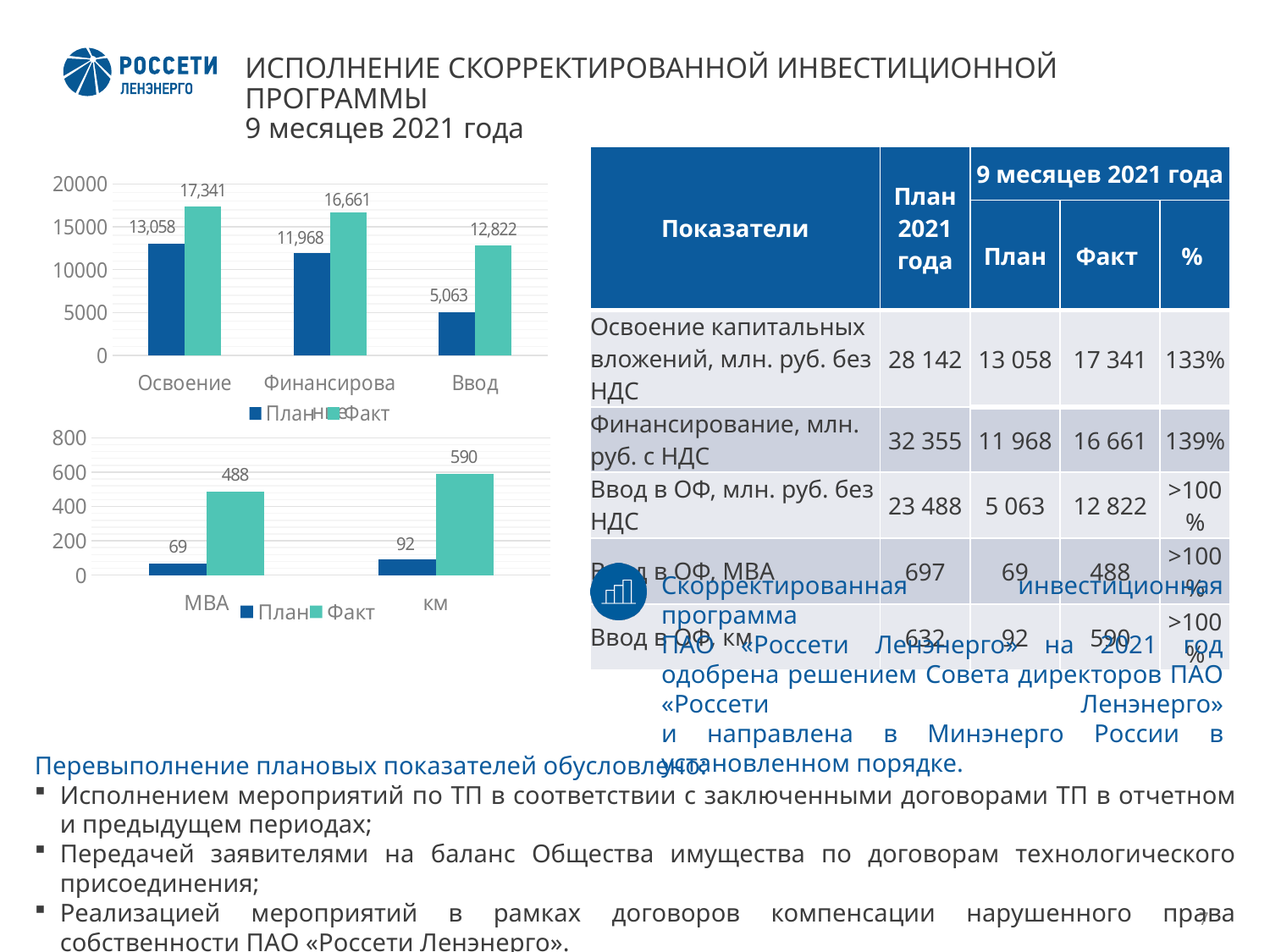
In the bottom chart, what is the План value for МВА? 69 In the bottom chart, which is larger: the Факт value for МВА or the Факт value for км? км What type of chart is the top chart? Bar chart In the bottom chart, what is the Факт value for км? 590 In the top chart, what is the Факт value for Ввод? 12,822 In the top chart, what is the План value for Освоение? 13,058 How many series does the legend of the bottom chart list? 2 In the top chart, which category has the highest Факт value? Освоение In the top chart, what is the difference between the Факт and План values for Ввод? 7,759 In the top chart, is the Факт value for Освоение greater or less than 15000? greater In the top chart, which category has the lowest План value? Ввод In the top chart, how many categories are shown on the x axis? 3